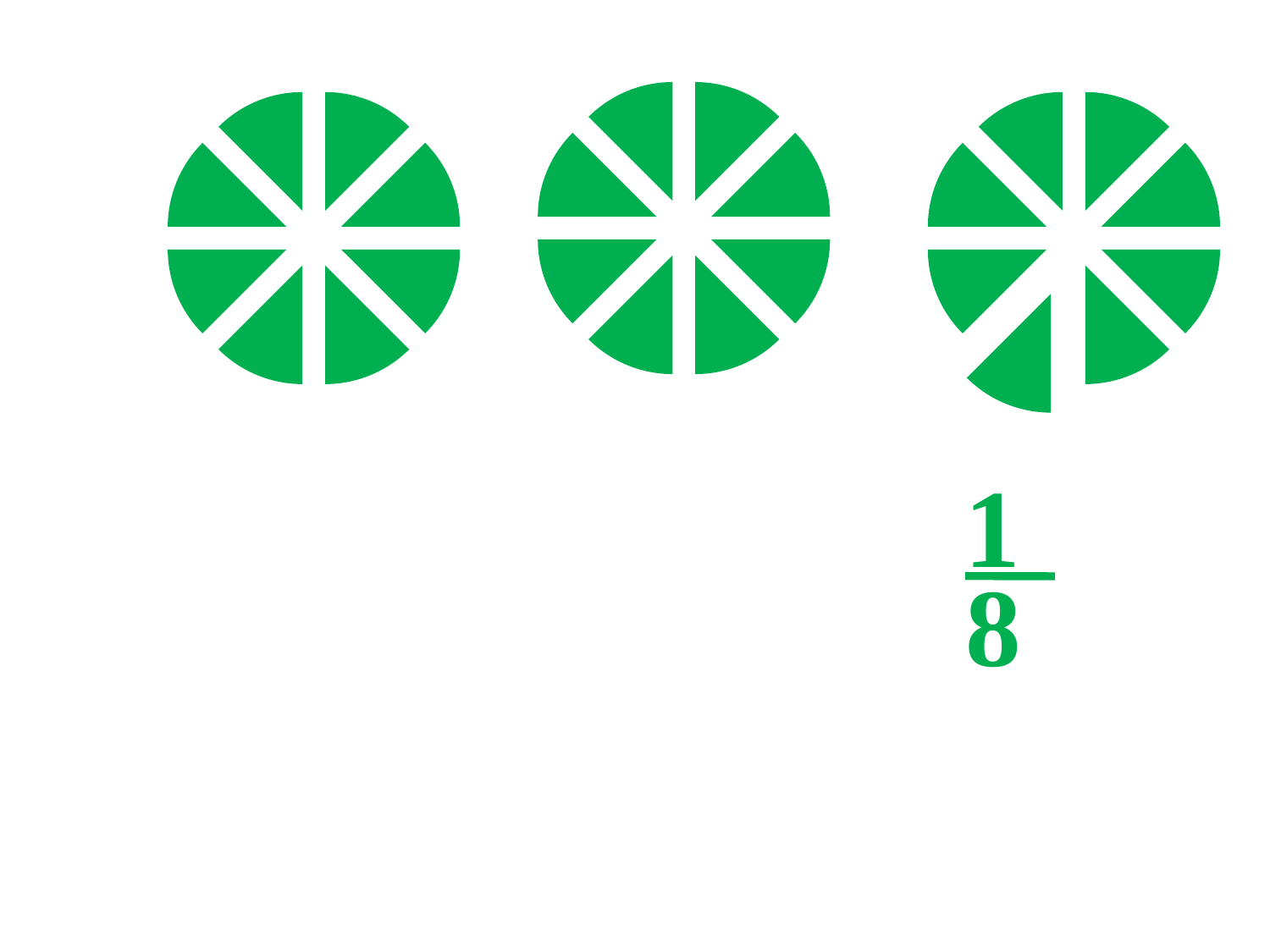
What colour are the slices of the pie charts? green How many pie charts are on the slide? 3 What kind of chart is shown on the left of the slide? pie chart How many slices does the rightmost pie chart have? 8 How many slices does the middle pie chart have? 8 In the rightmost pie chart, what share of the pie is the pulled-out slice, as labelled on the slide? 1/8 Which of the three pie charts has a slice pulled out from the rest? the rightmost